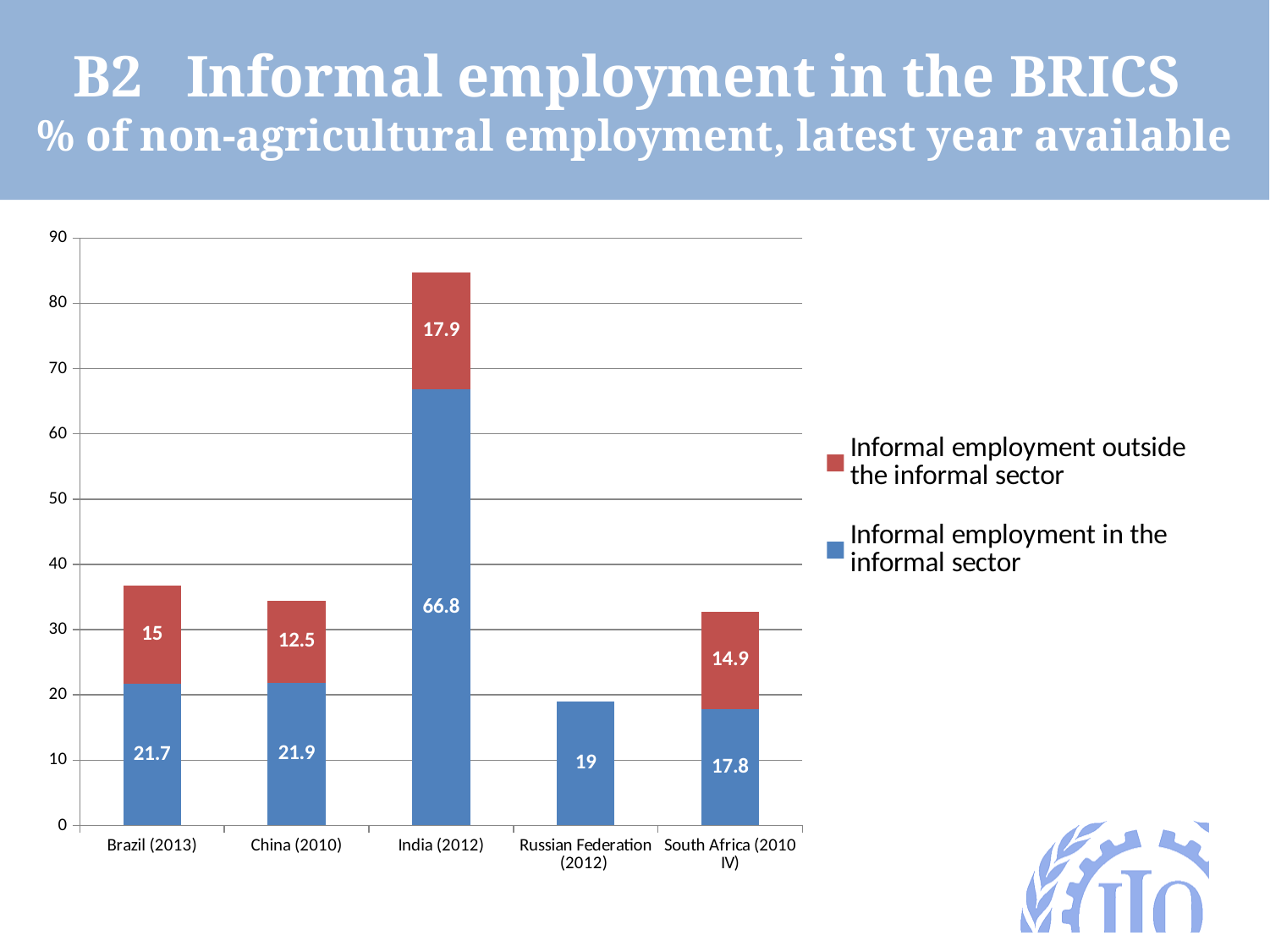
Which country has the highest value for informal employment in the informal sector? India (2012) What is the value of informal employment in the informal sector for the Russian Federation (2012)? 19 What is the value of informal employment in the informal sector for India (2012)? 66.8 How many countries are shown on the x axis? 5 What is the total of the stacked bar for Brazil (2013)? 36.7 How many series does the legend list? 2 What is the value of informal employment outside the informal sector for South Africa (2010 IV)? 14.9 Which country has the lowest value for informal employment in the informal sector? South Africa (2010 IV) What is the difference between the informal employment outside the informal sector values for India (2012) and China (2010)? 5.4 What kind of chart is shown on the slide? Stacked bar chart Which is larger: informal employment outside the informal sector for Brazil (2013) or for China (2010)? Brazil (2013) Is the total stacked bar for India (2012) greater or less than 80? greater